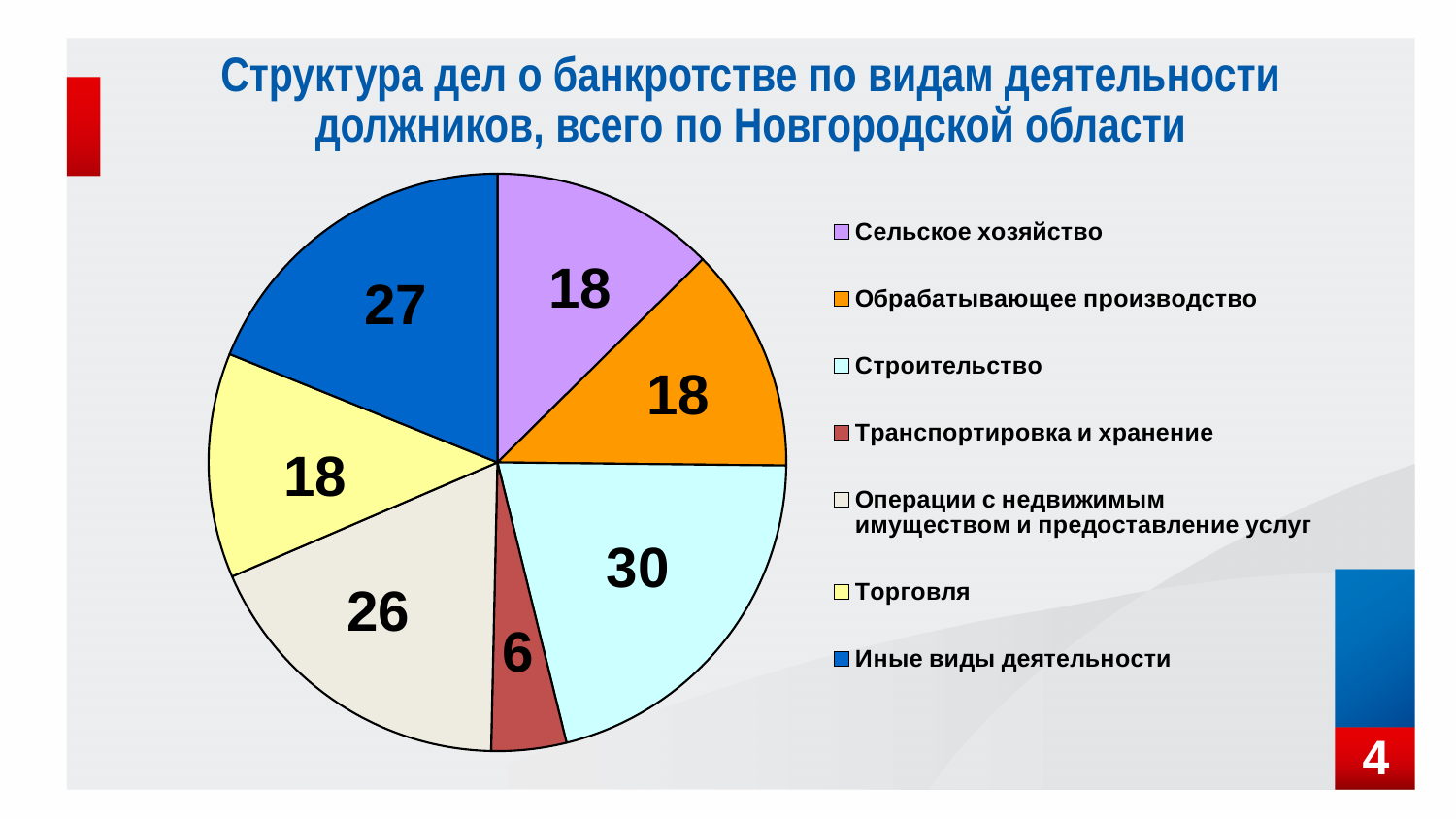
Which category has the largest slice of the pie? Строительство What is the value for Строительство? 30 Which category is shown in dark blue in the legend? Иные виды деятельности Which category has the smallest slice of the pie? Транспортировка и хранение What is the value for Транспортировка и хранение? 6 What is the sum of all the values shown in the pie chart? 143 Which is larger: the value for Иные виды деятельности or the value for Торговля? Иные виды деятельности What is the value for Иные виды деятельности? 27 What is the difference between the values for Строительство and Транспортировка и хранение? 24 What type of chart is shown on the slide? Pie chart What is the value for Операции с недвижимым имуществом и предоставление услуг? 26 How many categories does the pie chart have? 7